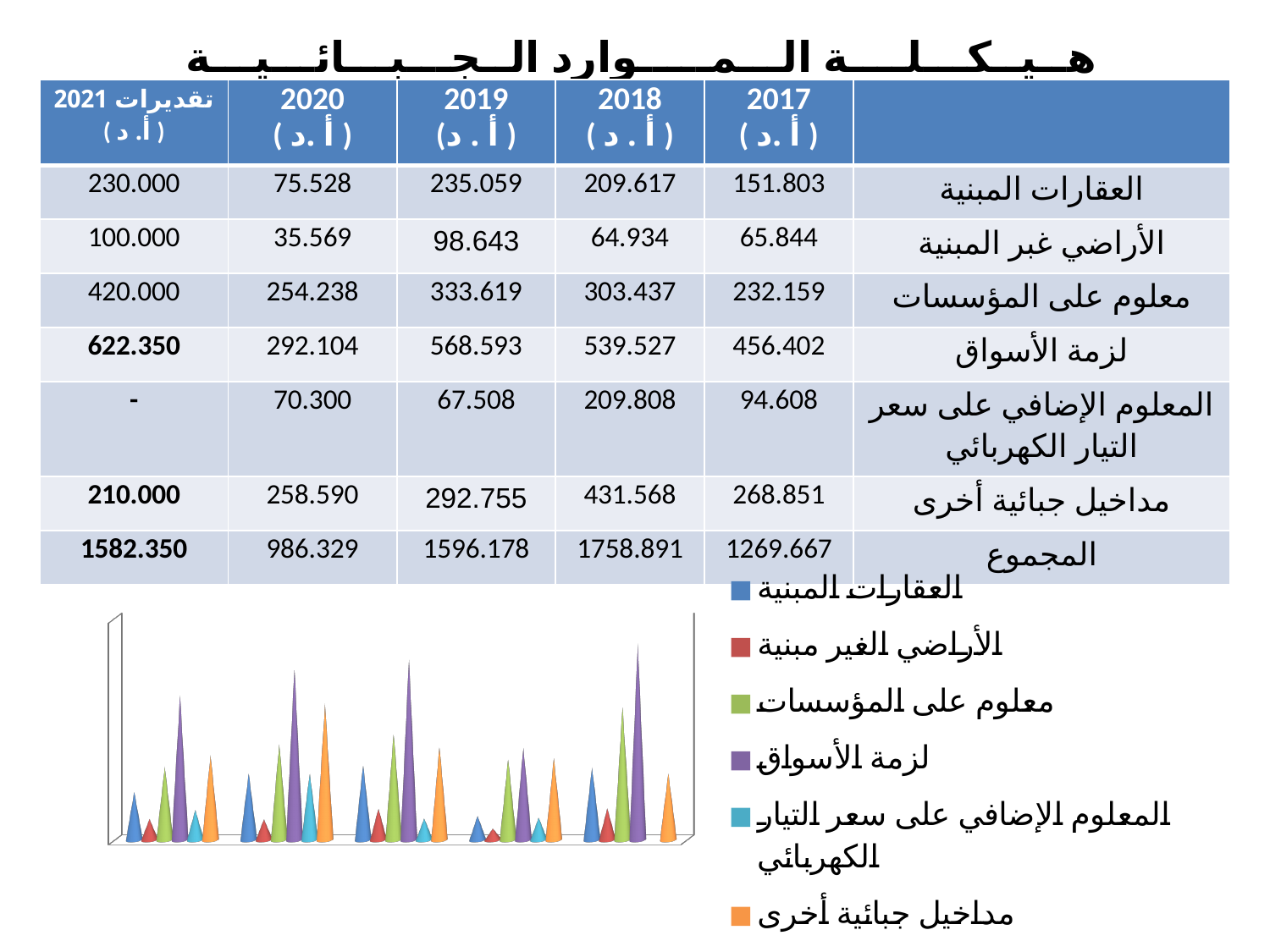
What colour represents مداخيل جبائية أخرى in the chart? orange How many groups of cones are plotted along the x axis of the chart? 5 In the second group from the left, which is taller: لزمة الأسواق or مداخيل جبائية أخرى? لزمة الأسواق In the leftmost group of the chart, which is taller: لزمة الأسواق or العقارات المبنية? لزمة الأسواق What kind of chart is shown at the bottom of the slide? bar chart What colour represents لزمة الأسواق in the chart? purple In the rightmost group of the chart, which series has the tallest cone? لزمة الأسواق How many series does the chart legend list? 6 In the leftmost group of the chart, which series has the shortest cone? الأراضي الغير مبنية Which legend series has no cone in the rightmost group of the chart? المعلوم الإضافي على سعر التيار الكهربائي In the leftmost group of the chart, which series has the tallest cone? لزمة الأسواق How many cones are plotted in the rightmost group of the chart? 5